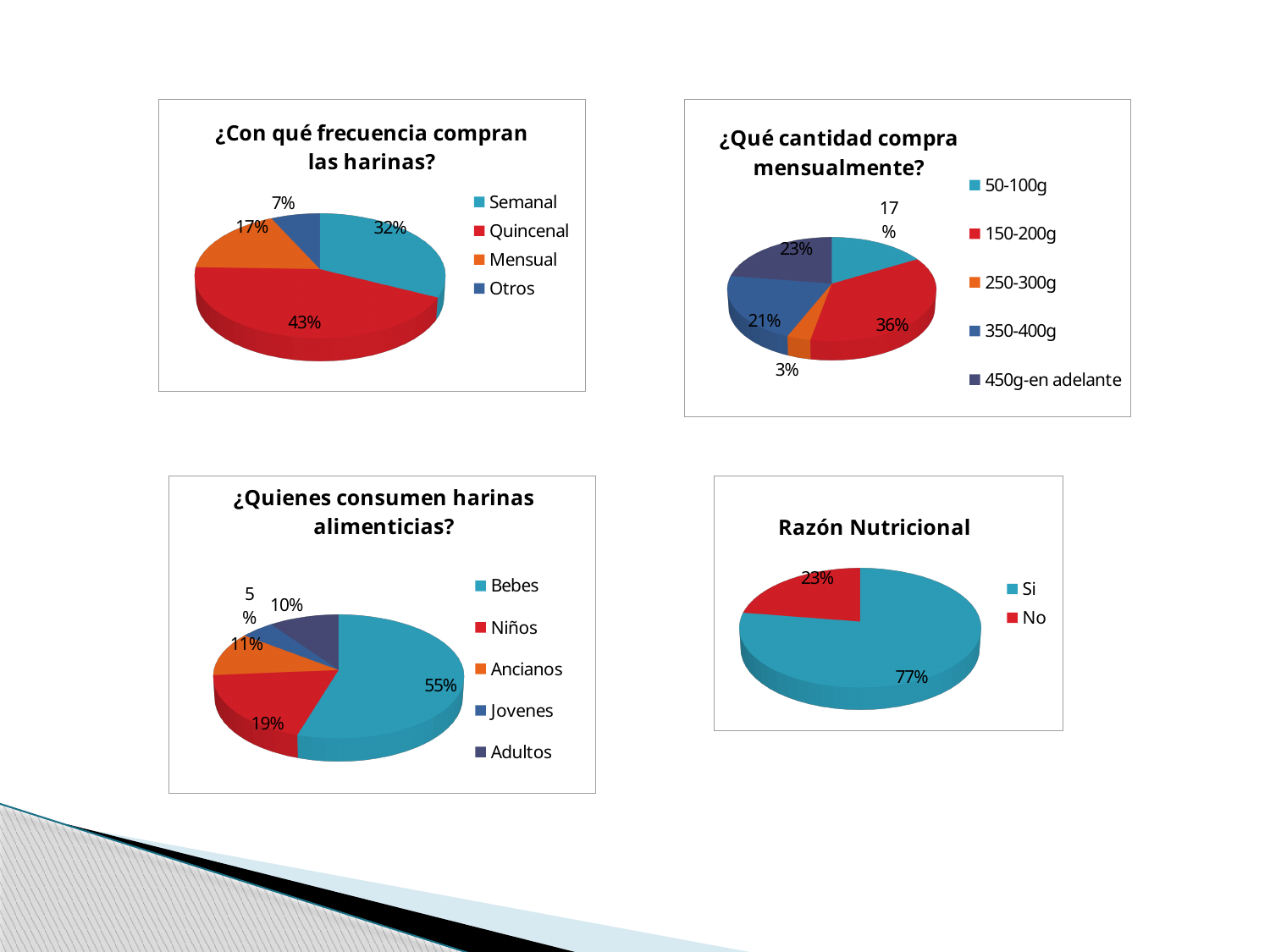
In the chart '¿Qué cantidad compra mensualmente?', how many categories does the legend list? 5 In the chart '¿Qué cantidad compra mensualmente?', what share is 350-400g? 21% In the chart '¿Con qué frecuencia compran las harinas?', which category has the smallest slice? Otros In the chart '¿Quienes consumen harinas alimenticias?', what is the difference between Niños and Adultos? 9% In the chart '¿Quienes consumen harinas alimenticias?', which category has the smallest slice? Jovenes What kind of chart is 'Razón Nutricional'? Pie chart In the chart '¿Qué cantidad compra mensualmente?', which category has the largest slice? 150-200g In the chart '¿Quienes consumen harinas alimenticias?', what share is Bebes? 55% In the chart '¿Con qué frecuencia compran las harinas?', what share is Quincenal? 43% In the chart 'Razón Nutricional', what share is No? 23% In the chart '¿Qué cantidad compra mensualmente?', which is larger, 50-100g or 450g-en adelante? 450g-en adelante In the chart '¿Con qué frecuencia compran las harinas?', what is the difference between Semanal and Mensual? 15%